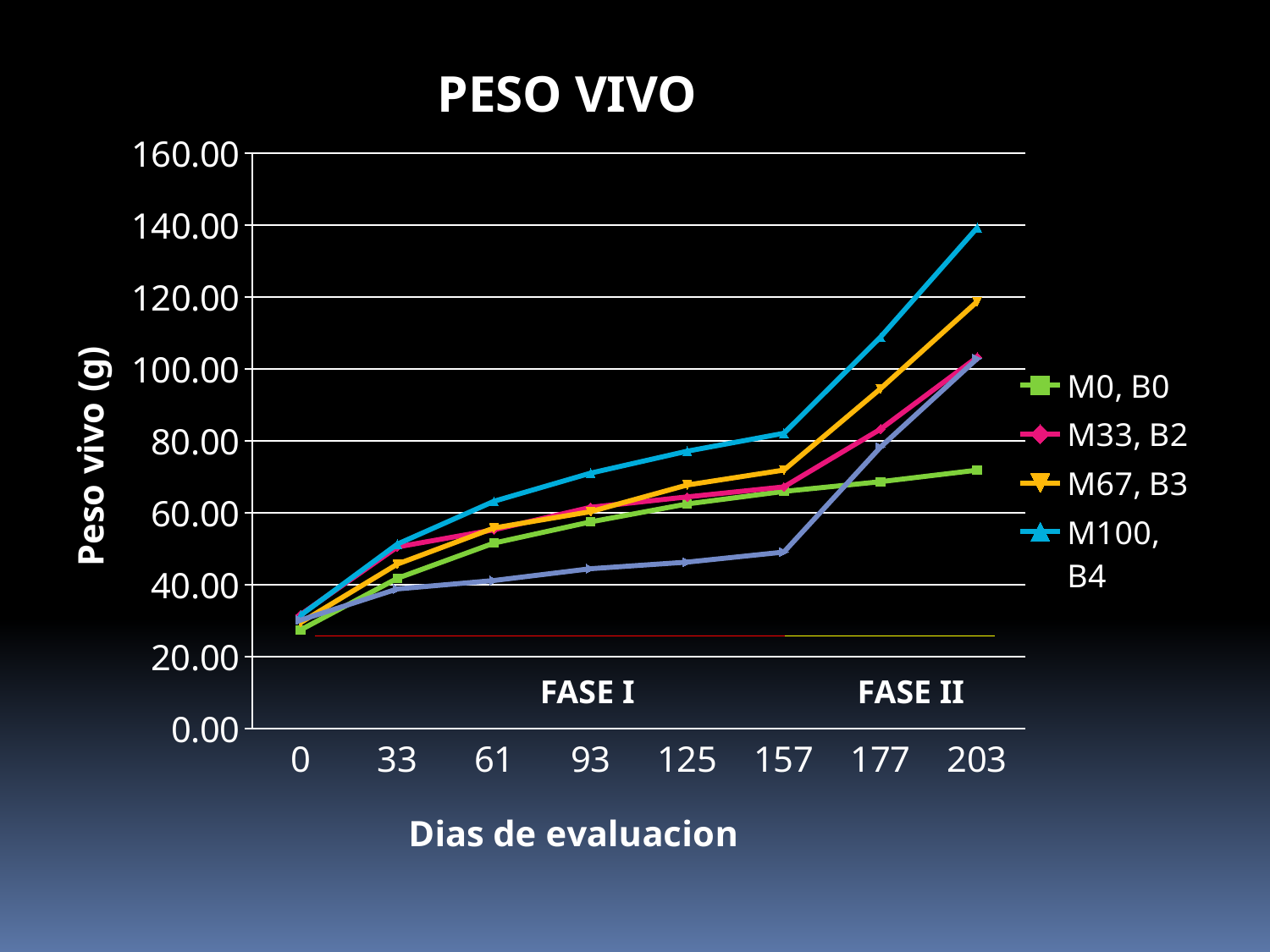
How many series does the legend list? 4 Is the value for M100, B4 at day 177 greater or less than 100? greater Do the values for M100, B4 rise or fall from day 0 to day 203? rise What kind of chart is shown on the slide? line chart What is the label of the x axis? Dias de evaluacion How many evaluation days (points) are shown on the x axis? 8 Which of the legend series has the lowest value at day 203? M0, B0 Is the value for M67, B3 at day 177 greater or less than 100? less Is the value for M100, B4 at day 203 greater or less than 120? greater Which series has the highest value at day 203? M100, B4 What is the title of the chart? PESO VIVO